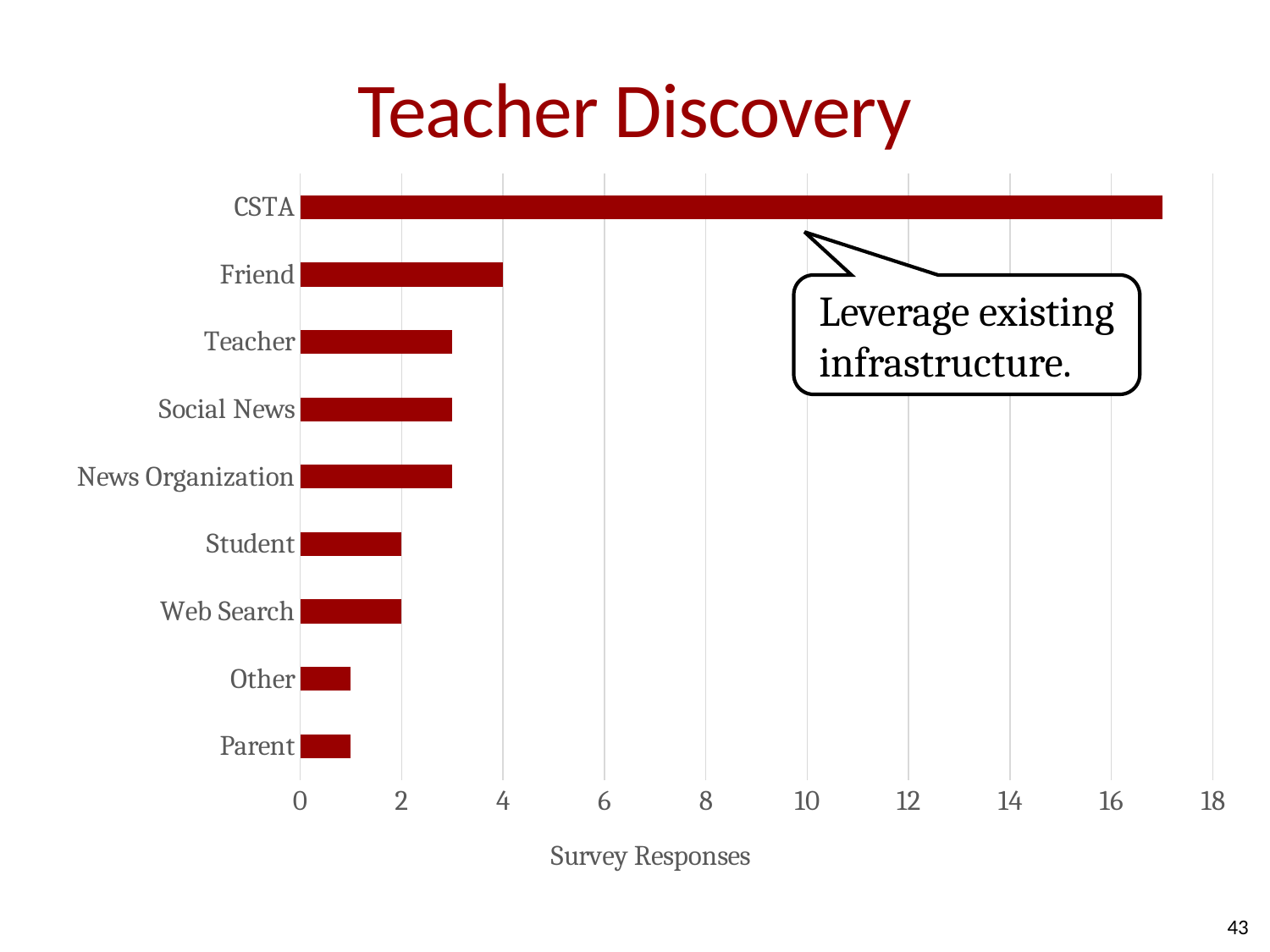
How many survey responses does Student have? 2 How many categories are shown in the chart? 9 What is the difference in survey responses between Friend and Student? 2 What is the label on the horizontal axis? Survey Responses How many survey responses does Web Search have? 2 Is the value for CSTA greater or less than 16? greater What is the title of the chart? Teacher Discovery How many survey responses does Friend have? 4 Is the value for Teacher greater or less than 4? less Which category has the highest number of survey responses? CSTA What kind of chart is shown on the slide? bar chart Which has more survey responses, CSTA or Friend? CSTA